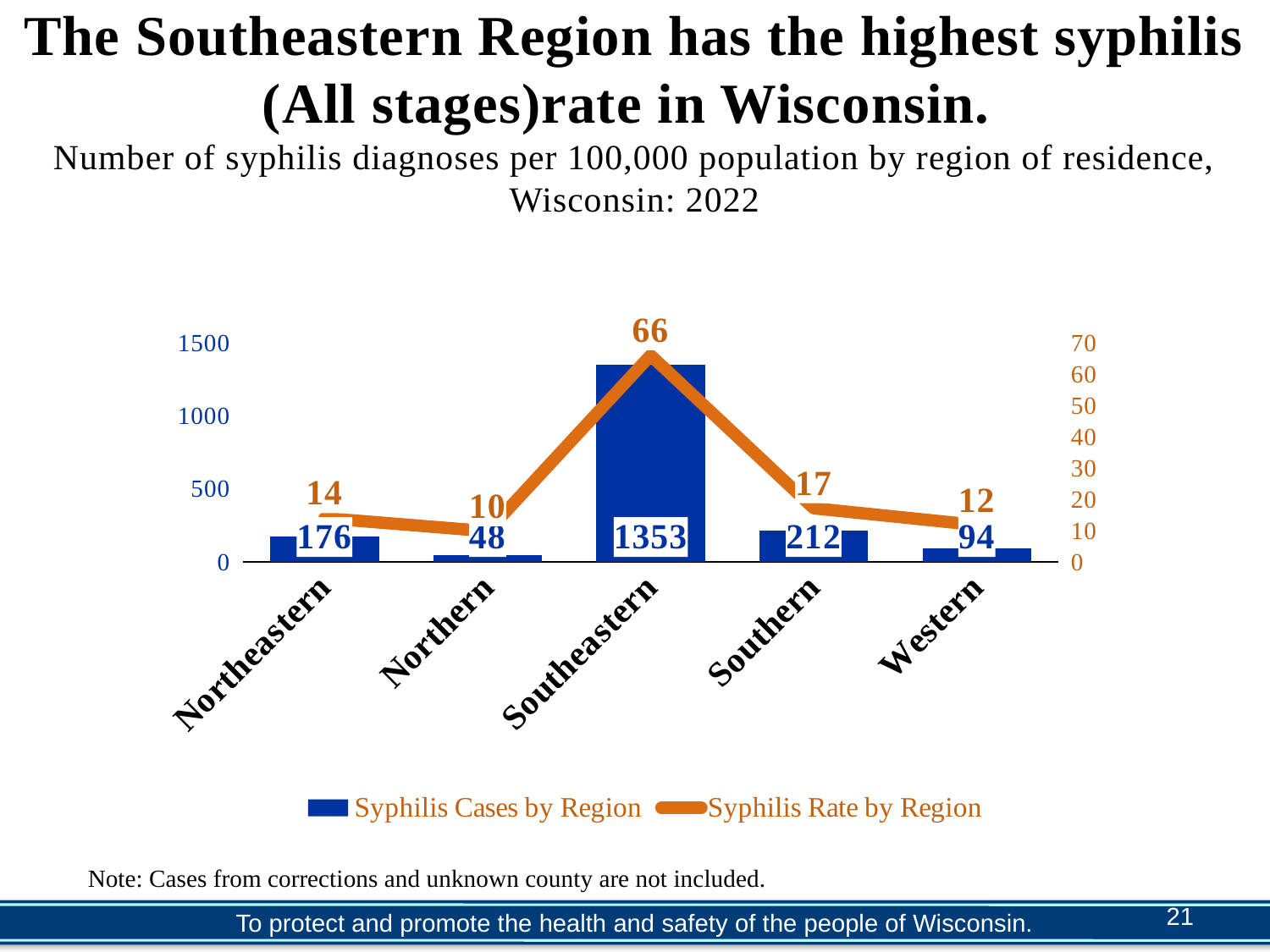
What is the syphilis rate by region for the Northern region? 10 How many series does the legend list? 2 What kind of chart is used to show syphilis cases by region? bar chart What is the difference in syphilis cases between the Southern and Northeastern regions? 36 Which region has the highest syphilis rate? Southeastern What colour is the line showing syphilis rate by region? orange What is the number of syphilis cases for the Western region? 94 Is the number of syphilis cases for the Southeastern region greater or less than 1000? greater Which region has the lowest number of syphilis cases? Northern How many syphilis cases are shown for the Southeastern region? 1353 Which region has more syphilis cases, Southern or Western? Southern How many regions are shown on the x axis? 5